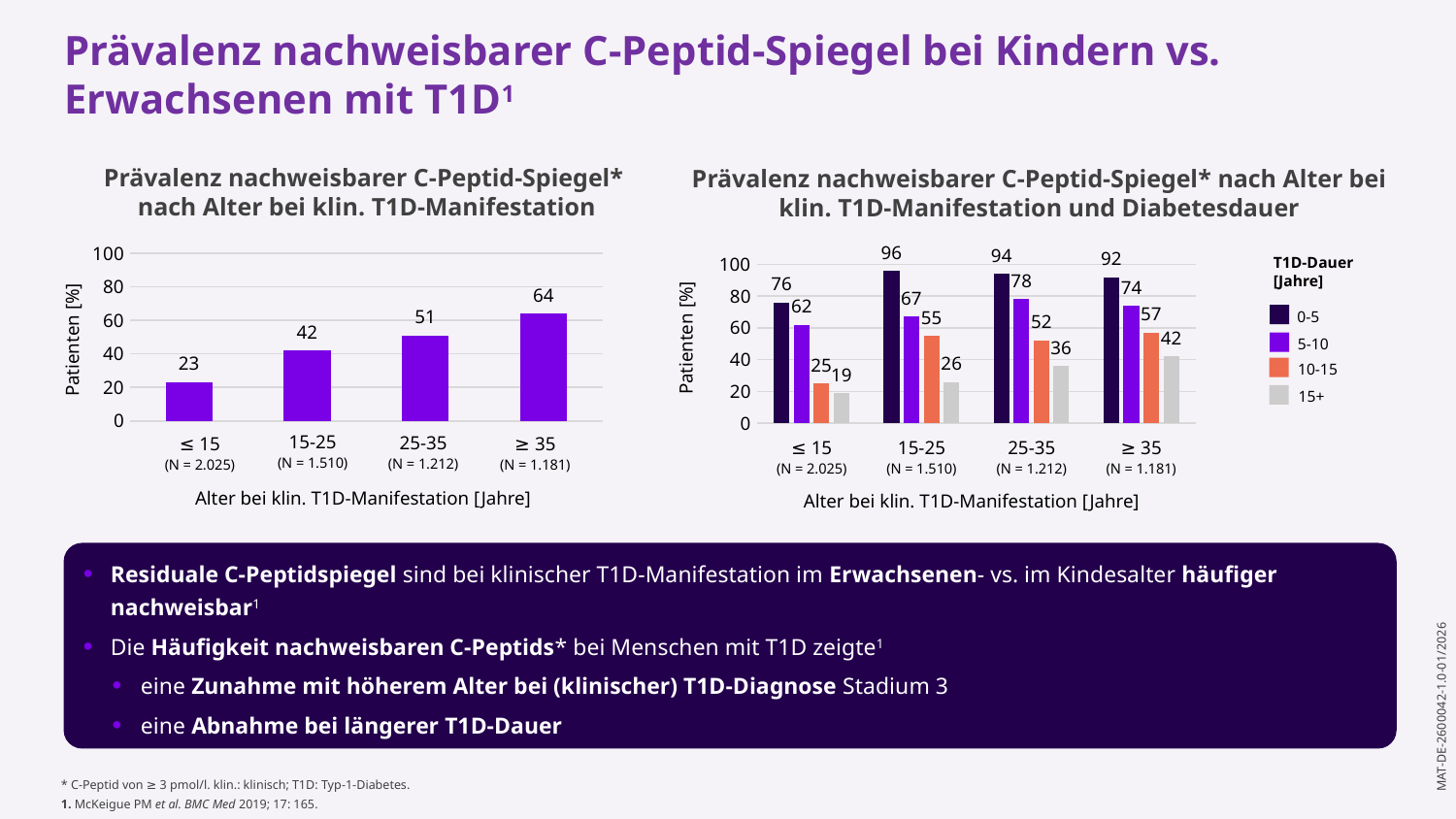
In the left chart, do the values rise or fall as age at T1D manifestation increases? rise How many age groups are shown on the x axis of the right chart? 4 In the left chart, what is the difference between the values for ≥ 35 and ≤ 15? 41 In the right chart, what is the value for the 15+ years T1D duration in the ≤ 15 age group? 19 In the left chart (Prävalenz nachweisbarer C-Peptid-Spiegel nach Alter bei klin. T1D-Manifestation), what is the value for the age group 15-25? 42 In the right chart, what is the difference between the 0-5 and 15+ values for the ≥ 35 age group? 50 In the right chart, which is larger for the 25-35 age group: the 5-10 or the 10-15 T1D duration value? 5-10 What type of chart is the left chart? bar chart In the right chart (nach Alter bei klin. T1D-Manifestation und Diabetesdauer), what is the value for the 0-5 years T1D duration in the 15-25 age group? 96 In the left chart, which age group has the highest value? ≥ 35 In the right chart, how many series does the legend list? 4 In the left chart, which age group has the lowest value? ≤ 15